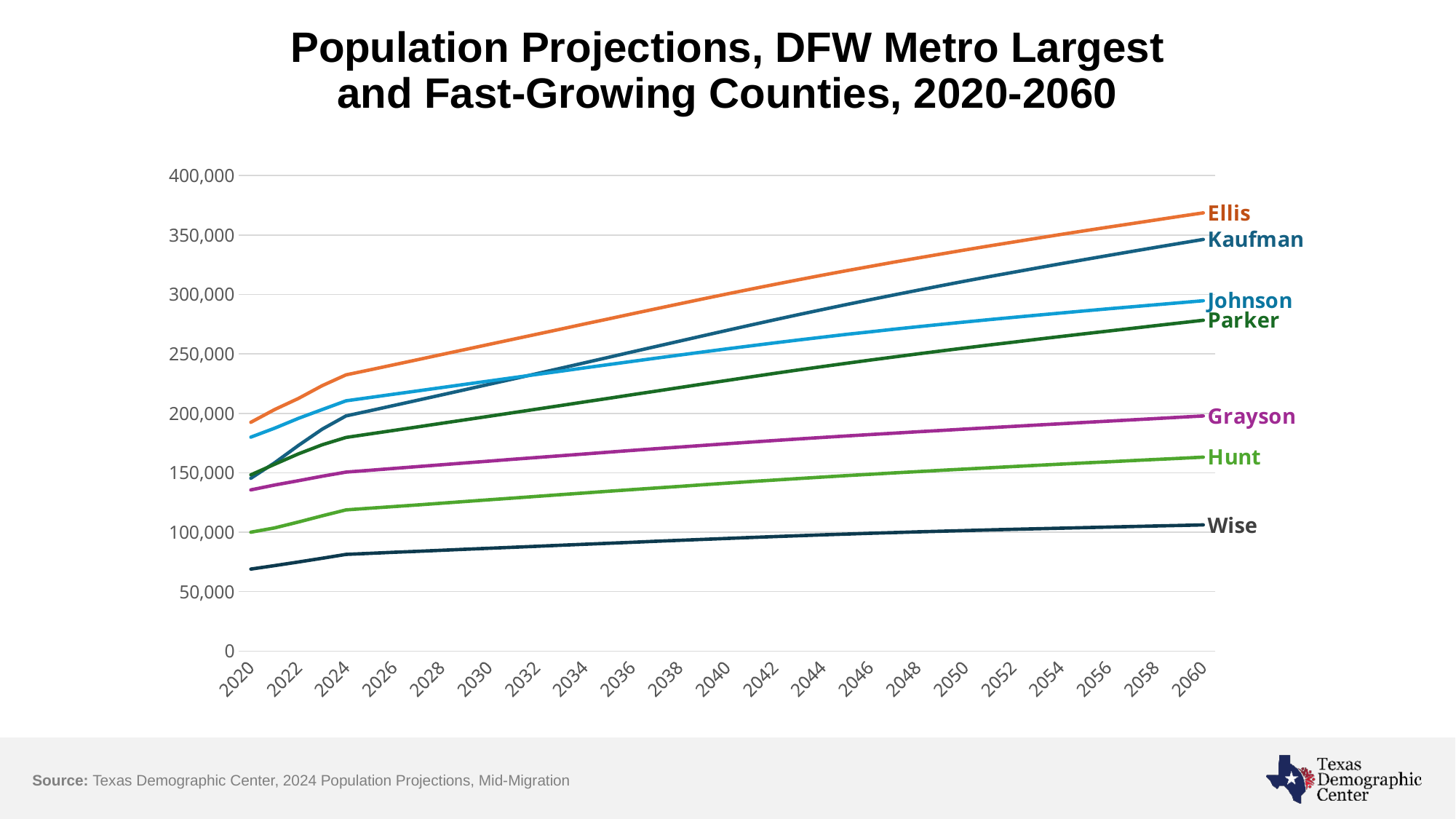
How many year labels are shown on the x axis? 21 Is the projected population for Johnson in 2060 greater or less than 300,000? less How many counties (lines) are plotted on the chart? 7 What kind of chart is shown on the slide? line chart In 2020, which county has the larger population, Johnson or Kaufman? Johnson Which county has the highest projected population in 2060? Ellis Which county has the lowest projected population across the whole period? Wise Does the projected population for Hunt rise or fall from 2020 to 2060? rise In 2060, which county has the larger projected population, Kaufman or Johnson? Kaufman What is the title of the chart? Population Projections, DFW Metro Largest and Fast-Growing Counties, 2020-2060 Is the population for Wise in 2020 greater or less than 100,000? less Is the projected population for Ellis in 2060 greater or less than 350,000? greater